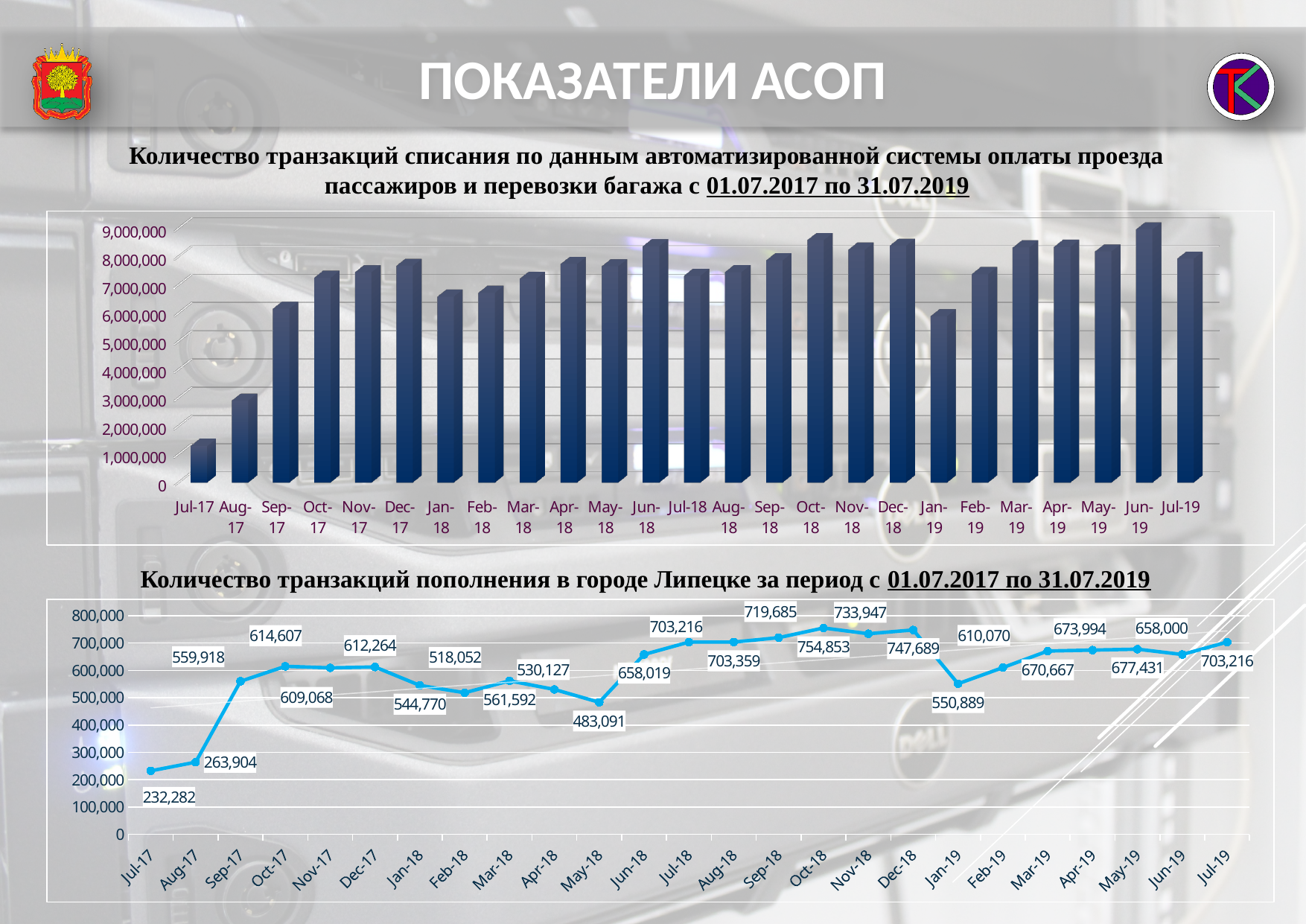
What type of chart is the top chart (transactions of write-off)? bar chart In the bottom chart, what is the value for Oct-18? 754,853 In the bottom chart, which month has the lowest value? Jul-17 In the bottom chart, which is larger, the value for Dec-18 or the value for Jan-19? Dec-18 In the bottom chart, which month has the highest value? Oct-18 In the bottom chart, what is the value for Jul-17? 232,282 In the top chart, is the value for Jun-19 greater or less than 8,000,000? greater In the bottom chart, what is the difference between the values for Jul-19 and Jun-19? 45,216 In the top chart, is the value for Jul-17 greater or less than 2,000,000? less What type of chart is the bottom chart (top-up transactions in Lipetsk)? line chart How many months are plotted in the top chart? 25 In the bottom chart, what is the value for May-18? 483,091